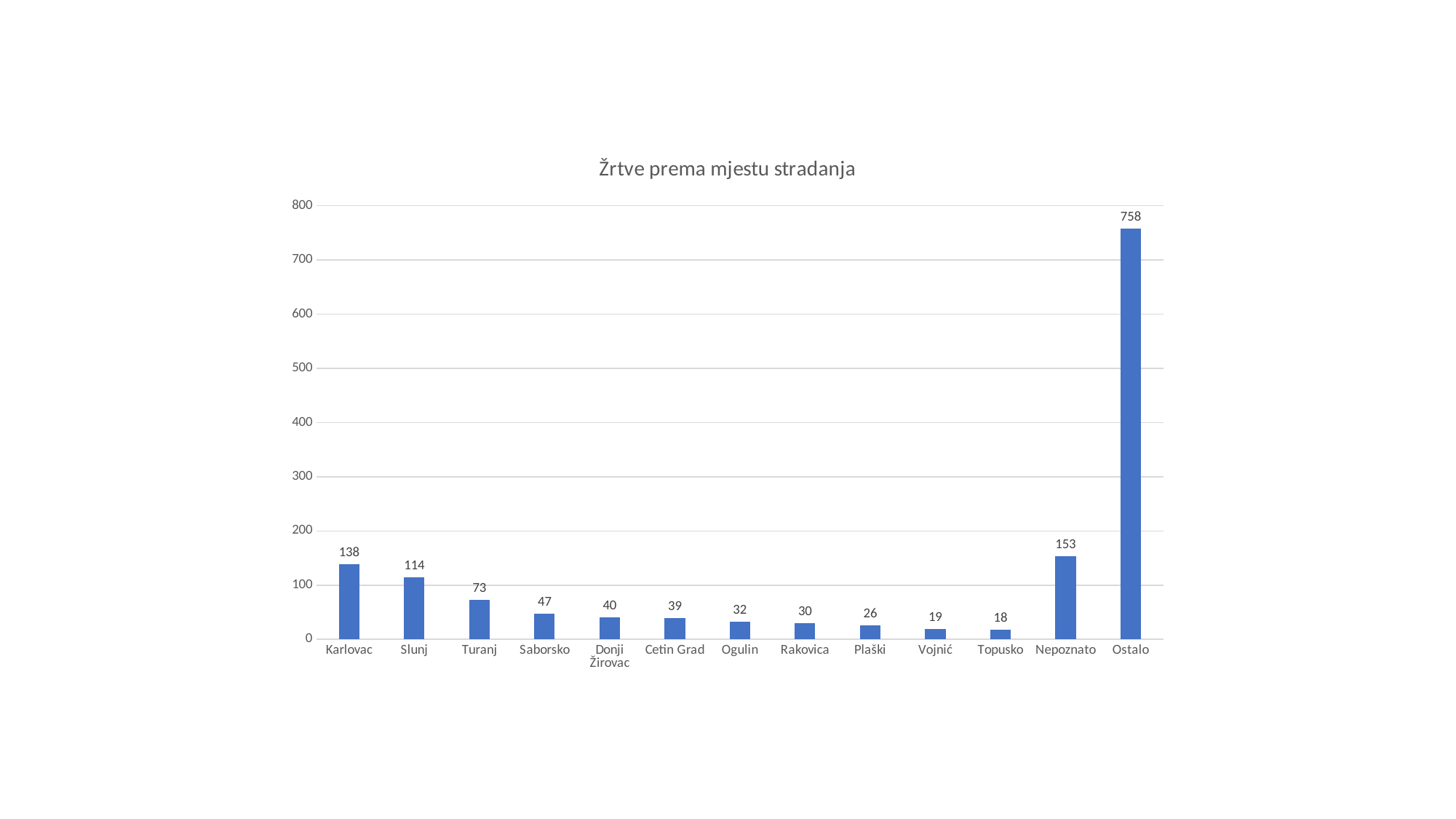
What is the value for Donji Žirovac? 40 What is the value for Nepoznato? 153 What is the difference between the values for Ostalo and Nepoznato? 605 Is the value for Ostalo greater or less than 700? greater Which is larger, the value for Turanj or the value for Saborsko? Turanj How many categories are shown on the x axis? 13 Which category has the lowest value? Topusko What kind of chart is this? bar chart What is the difference between the values for Karlovac and Slunj? 24 What is the value for Karlovac? 138 Which category has the highest value? Ostalo What is the title of the chart? Žrtve prema mjestu stradanja